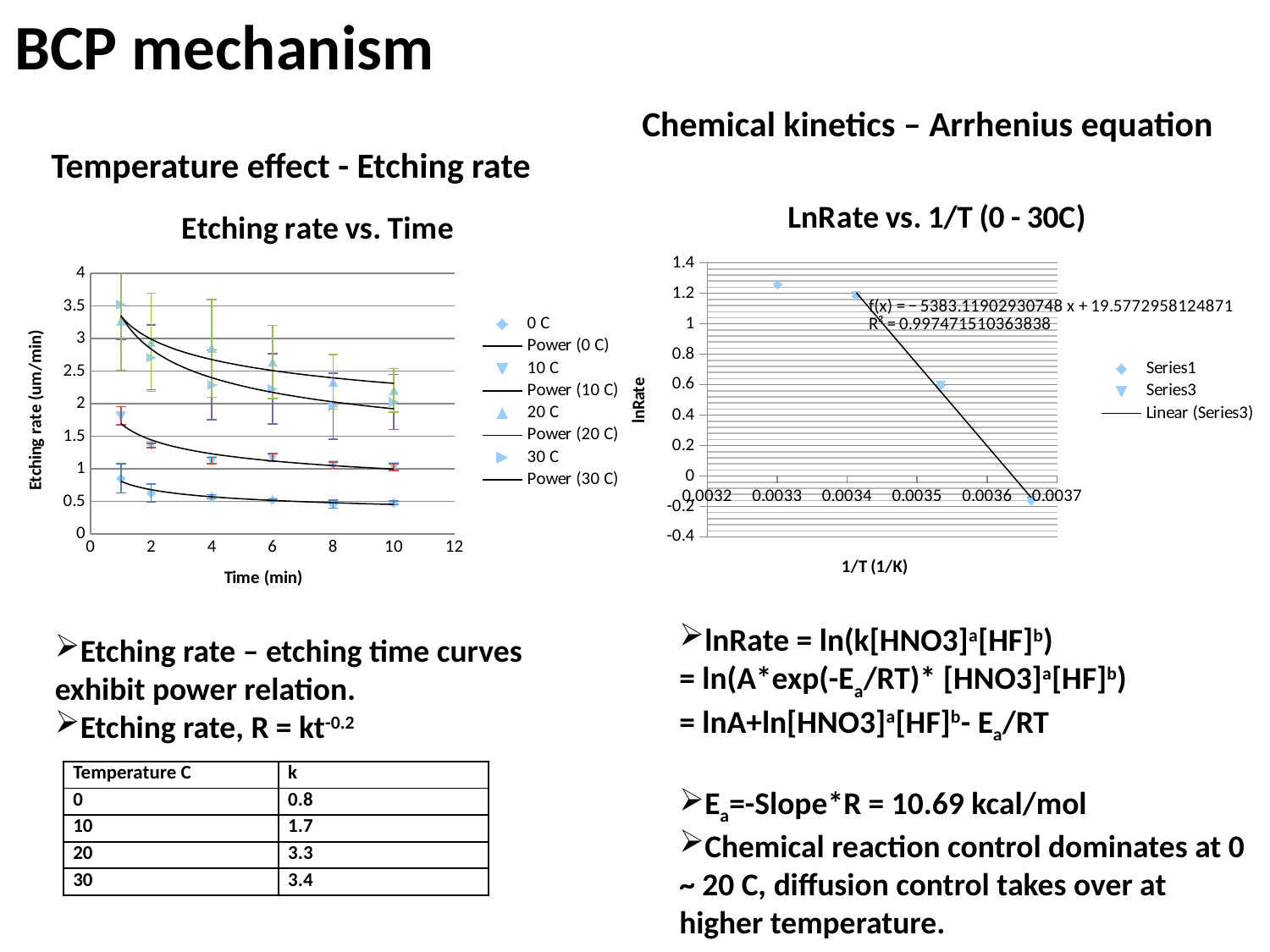
How many data points are plotted in the 'LnRate vs. 1/T (0 - 30C)' chart? 4 What kind of chart is the 'Etching rate vs. Time' chart on the left? scatter chart In the 'LnRate vs. 1/T (0 - 30C)' chart, what R² value is printed for the linear fit? 0.997471510363838 What is the y-axis title of the 'LnRate vs. 1/T (0 - 30C)' chart? lnRate In the 'Etching rate vs. Time' chart, is the value for 0 C at 10 min greater or less than 1? less In the 'LnRate vs. 1/T (0 - 30C)' chart, does lnRate rise or fall as 1/T increases? fall In the 'Etching rate vs. Time' chart, which temperature series has the lowest etching rate at 10 min? 0 C How many entries does the legend of the 'LnRate vs. 1/T (0 - 30C)' chart list? 3 In the 'Etching rate vs. Time' chart, is the value for 30 C at 1 min greater or less than 3? greater How many entries does the legend of the 'Etching rate vs. Time' chart list? 8 What is the x-axis title of the 'Etching rate vs. Time' chart? Time (min) In the 'LnRate vs. 1/T (0 - 30C)' chart, what is the slope in the printed trendline equation? −5383.11902930748